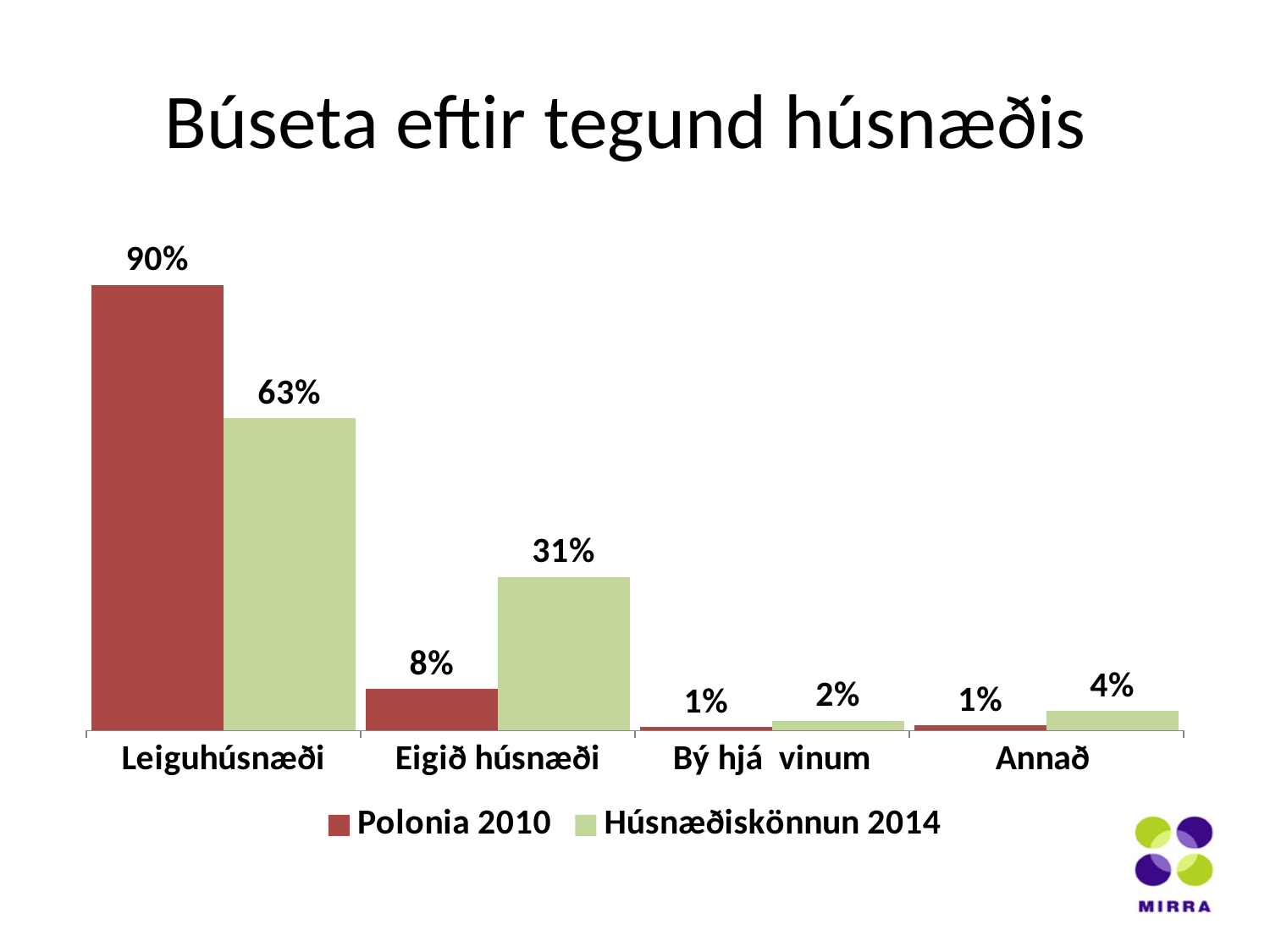
How many series does the legend list? 2 Which is larger for Eigið húsnæði: Polonia 2010 or Húsnæðiskönnun 2014? Húsnæðiskönnun 2014 What is the value for Annað in the Húsnæðiskönnun 2014 series? 4% What kind of chart is shown on the slide? Bar chart What is the value for Leiguhúsnæði in the Polonia 2010 series? 90% Which category has the highest value in the Húsnæðiskönnun 2014 series? Leiguhúsnæði Which category has the lowest value in the Húsnæðiskönnun 2014 series? Bý hjá vinum How many categories are shown on the x axis? 4 What is the value for Bý hjá vinum in the Polonia 2010 series? 1% What is the difference between the Húsnæðiskönnun 2014 and Polonia 2010 values for Eigið húsnæði? 23% What is the difference between the Polonia 2010 and Húsnæðiskönnun 2014 values for Leiguhúsnæði? 27% What is the value for Eigið húsnæði in the Húsnæðiskönnun 2014 series? 31%